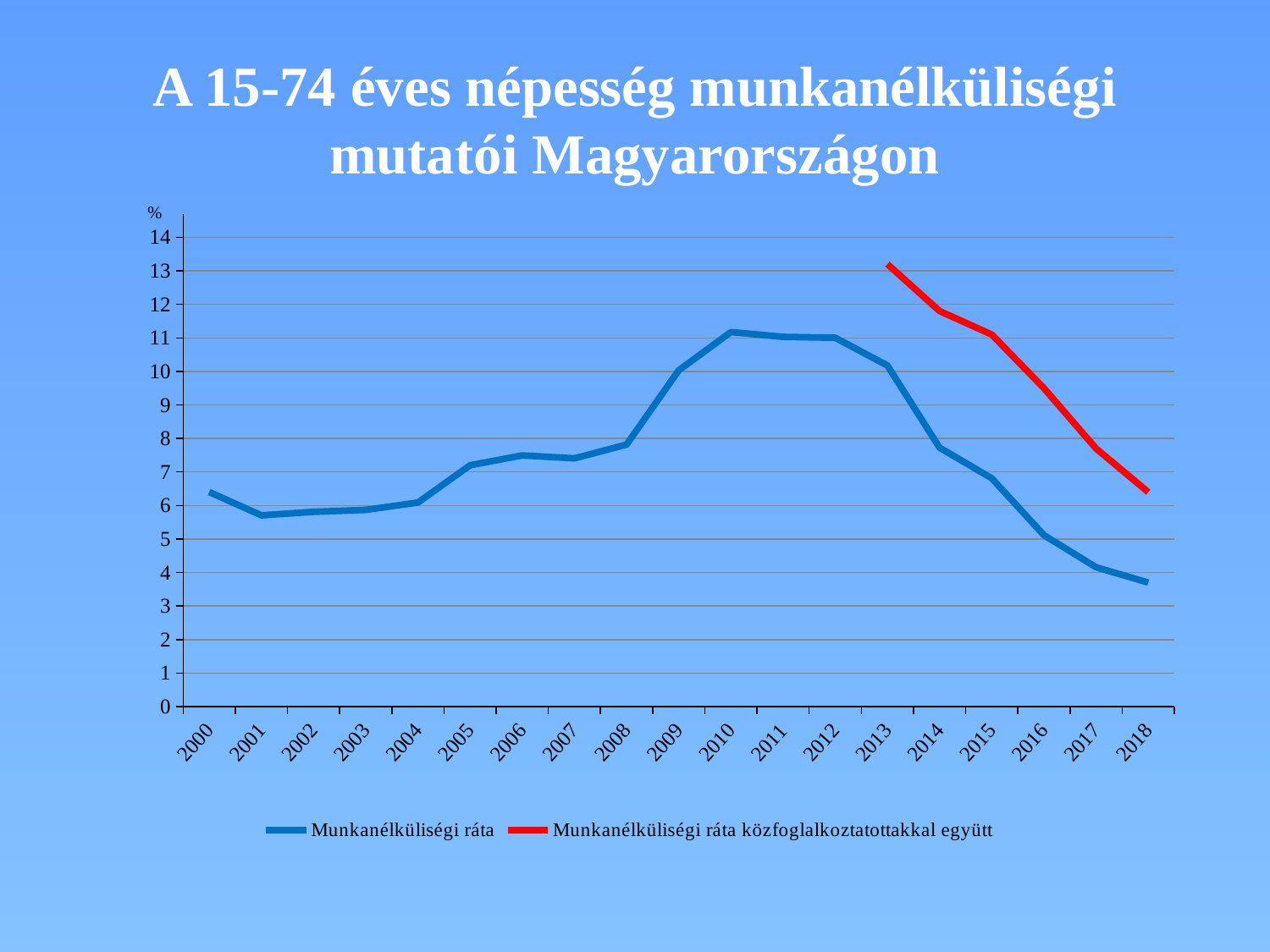
In 2016, which series has the higher value: Munkanélküliségi ráta or Munkanélküliségi ráta közfoglalkoztatottakkal együtt? Munkanélküliségi ráta közfoglalkoztatottakkal együtt In which year does the Munkanélküliségi ráta series reach its lowest value? 2018 What kind of chart is shown on the slide? line chart In which year is the Munkanélküliségi ráta közfoglalkoztatottakkal együtt series highest? 2013 How many years are shown along the x axis? 19 Is the value of Munkanélküliségi ráta in 2018 greater or less than 4? less How many series does the legend list? 2 What colour is the line for Munkanélküliségi ráta közfoglalkoztatottakkal együtt? red In which year does the Munkanélküliségi ráta series reach its highest value? 2010 Is the value of Munkanélküliségi ráta közfoglalkoztatottakkal együtt in 2013 greater or less than 12? greater Does the Munkanélküliségi ráta series rise or fall between 2013 and 2018? fall Is the value of Munkanélküliségi ráta in 2001 greater or less than 6? less